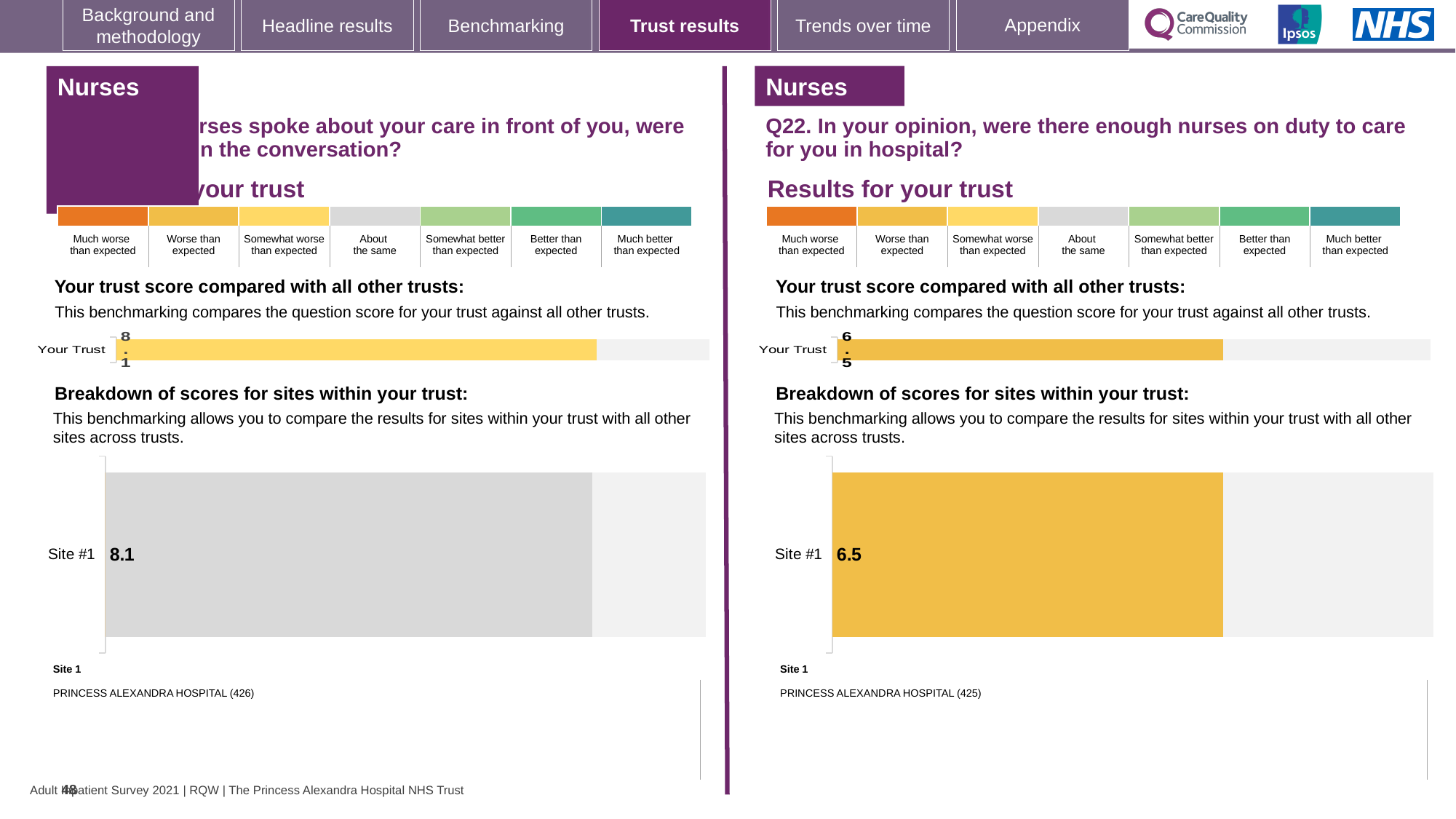
What type of chart is used to show the Site #1 score on the right-hand Q22 section? Bar chart What is the difference between the Site #1 score on the left-hand chart and the Site #1 score on the right-hand Q22 chart? 1.6 Which is larger: the Site #1 score on the left-hand chart or the Site #1 score on the right-hand Q22 chart? Left-hand chart (8.1) What colour is the Site #1 bar on the left-hand breakdown chart? Grey On the left-hand chart, what is the score shown for Your Trust? 8.1 On the right-hand chart for Q22, what is the score shown for Your Trust? 6.5 On the left-hand breakdown of scores for sites, what is the score for Site #1? 8.1 On the right-hand Q22 breakdown of scores for sites, what is the score for Site #1? 6.5 Which site name is listed under Site 1 on the right-hand Q22 section? PRINCESS ALEXANDRA HOSPITAL (425) How many sites are shown in the right-hand Q22 breakdown of scores for sites within your trust? 1 On the right-hand Q22 chart, is the Your Trust score greater or less than the Site #1 score, or are they equal? Equal